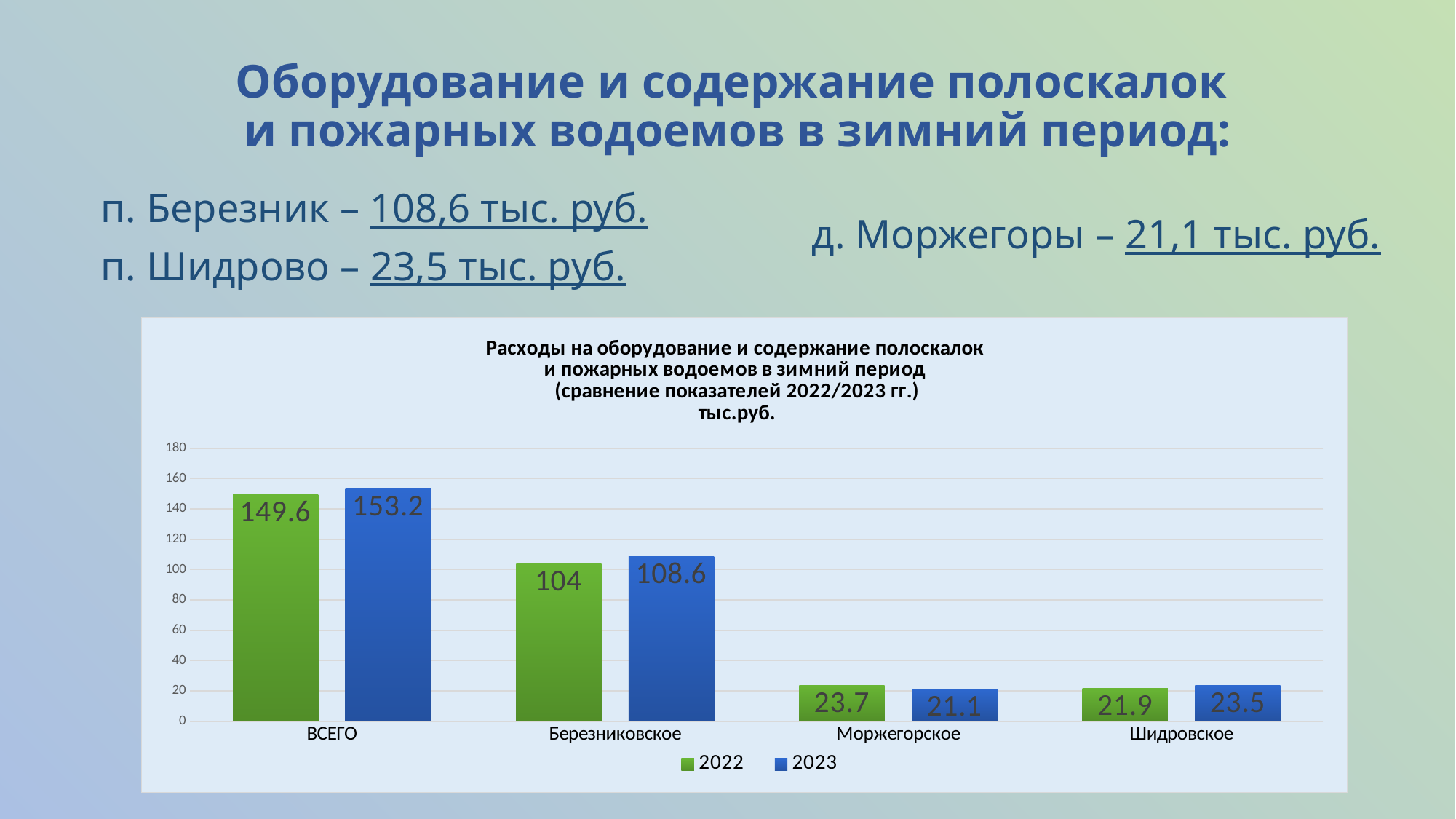
How many categories are shown on the x axis? 4 Which is larger for Моржегорское, the 2022 value or the 2023 value? 2022 Which category has the lowest 2023 value? Моржегорское What is the difference between the 2023 and 2022 values for Березниковское? 4.6 What is the 2023 value for Березниковское? 108.6 Is the 2023 value for Шидровское greater or less than 40? less How many series does the legend list? 2 Which category has the highest 2022 value? ВСЕГО What is the 2022 value for Моржегорское? 23.7 What kind of chart is shown on the slide? bar chart What is the difference between the 2023 and 2022 values for ВСЕГО? 3.6 What is the 2022 value for ВСЕГО? 149.6